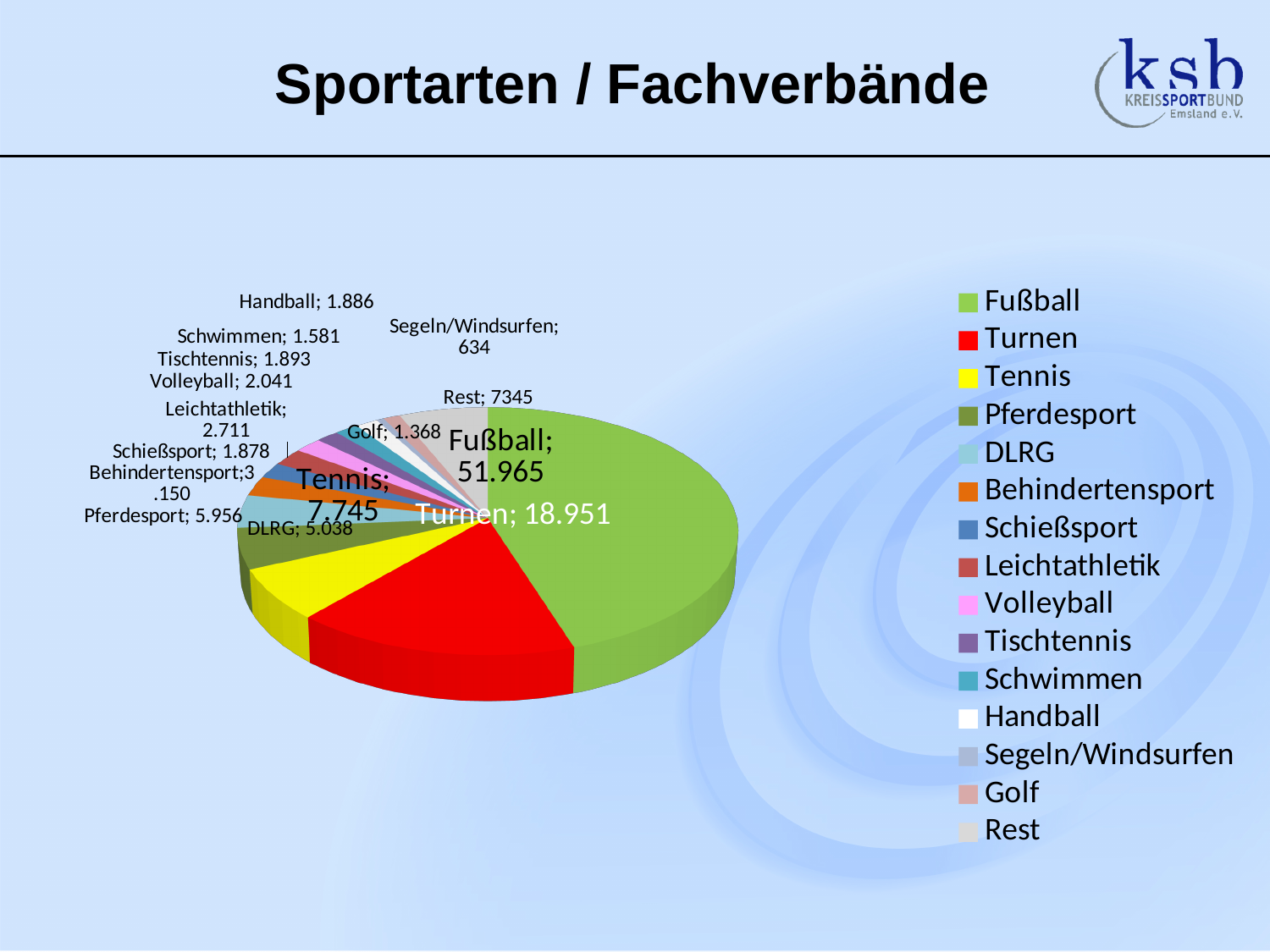
What is the value shown for Fußball? 51.965 What colour is the Turnen slice in the pie chart? red What is the value shown for Segeln/Windsurfen? 634 Which category has the smallest value in the pie chart? Segeln/Windsurfen What kind of chart is shown on the slide? pie chart What is the value shown for Turnen? 18.951 What is the value shown for DLRG? 5.038 Which category has the largest slice of the pie? Fußball What is the value shown for Rest? 7345 What is the difference between the values for Fußball and Turnen? 33.014 How many categories does the legend list? 15 Which is larger, the value for Pferdesport or the value for DLRG? Pferdesport